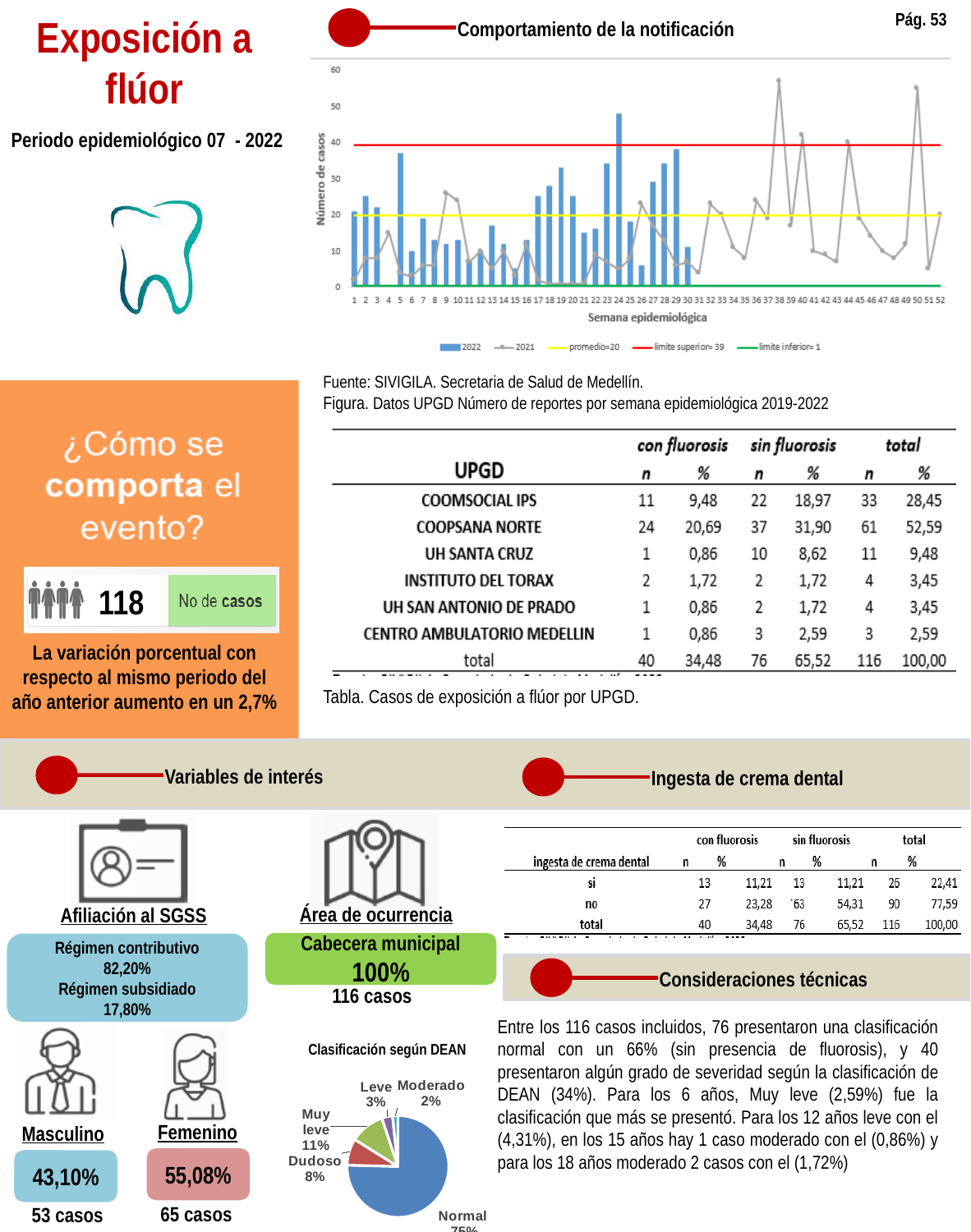
In the 'Comportamiento de la notificación' chart, is the 2022 value for week 24 greater or less than 40? greater In the 'Comportamiento de la notificación' chart, how many series does the legend list? 5 What kind of chart is 'Clasificación según DEAN'? pie chart In the 'Comportamiento de la notificación' chart, which epidemiological week has the highest 2022 bar? 24 In the 'Clasificación según DEAN' pie chart, how many slices are there? 5 In the 'Clasificación según DEAN' pie chart, what share does 'Muy leve' have? 11% In the 'Comportamiento de la notificación' chart, what is the label of the x axis? Semana epidemiológica In the 'Clasificación según DEAN' pie chart, which category has the largest slice? Normal In the 'Clasificación según DEAN' pie chart, what share does 'Dudoso' have? 8% In the 'Comportamiento de la notificación' chart, is the 2021 value for week 38 greater or less than 50? greater In the 'Comportamiento de la notificación' chart, what value does the legend give for 'promedio'? 20 In the 'Comportamiento de la notificación' chart, what value does the legend give for 'limite superior'? 39